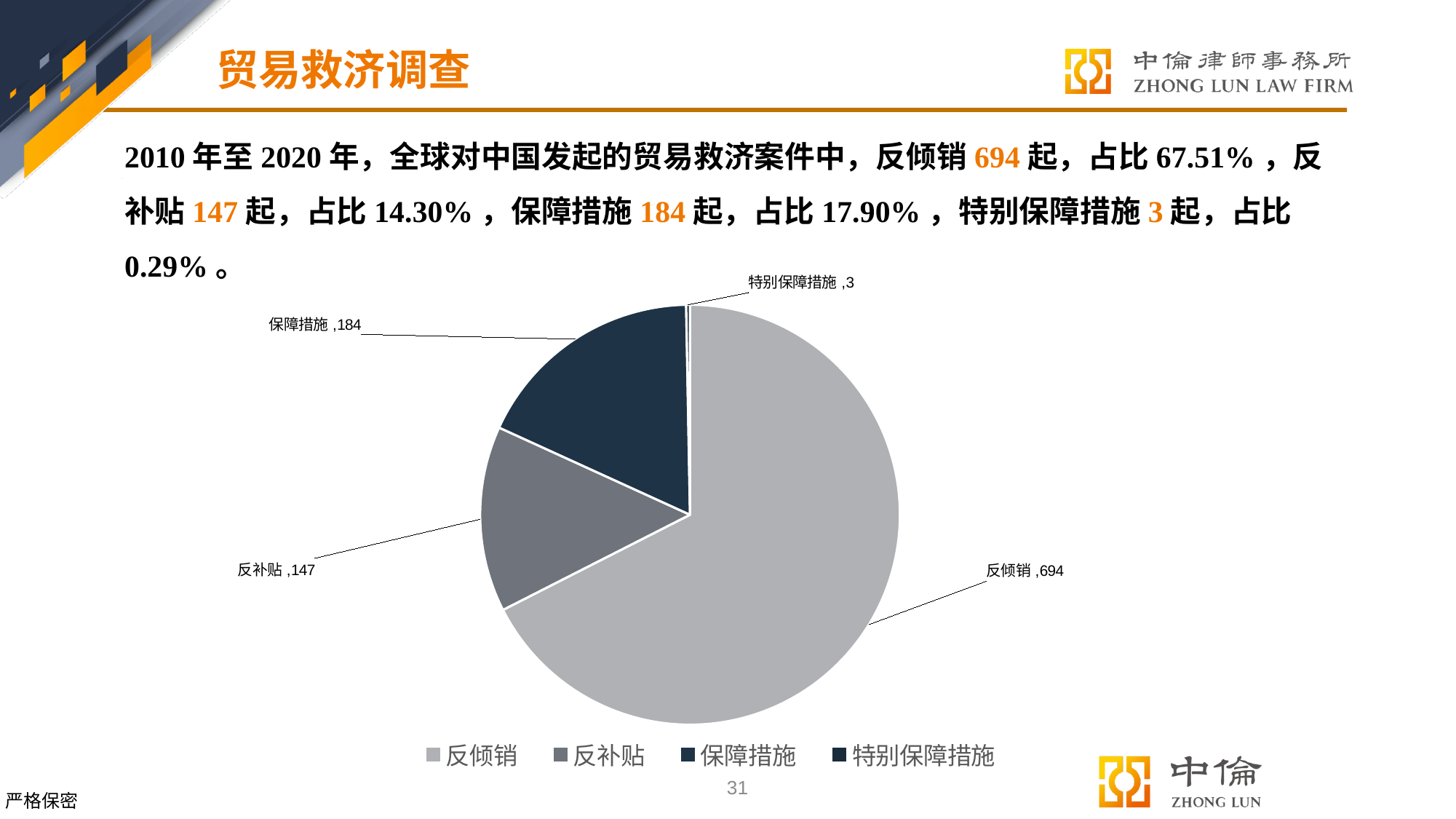
Which category has the smallest slice in the pie chart? 特别保障措施 Which category has the largest slice in the pie chart? 反倾销 What is the value for 保障措施 in the pie chart? 184 What type of chart is shown on the slide? pie chart Which is larger, the value for 保障措施 or the value for 反补贴? 保障措施 What is the value for 反补贴 in the pie chart? 147 How many entries does the legend of the pie chart list? 4 What is the value for 反倾销 in the pie chart? 694 What is the value for 特别保障措施 in the pie chart? 3 How many slices does the pie chart have? 4 What is the difference between the values for 保障措施 and 反补贴? 37 What is the total of all four slices in the pie chart? 1028